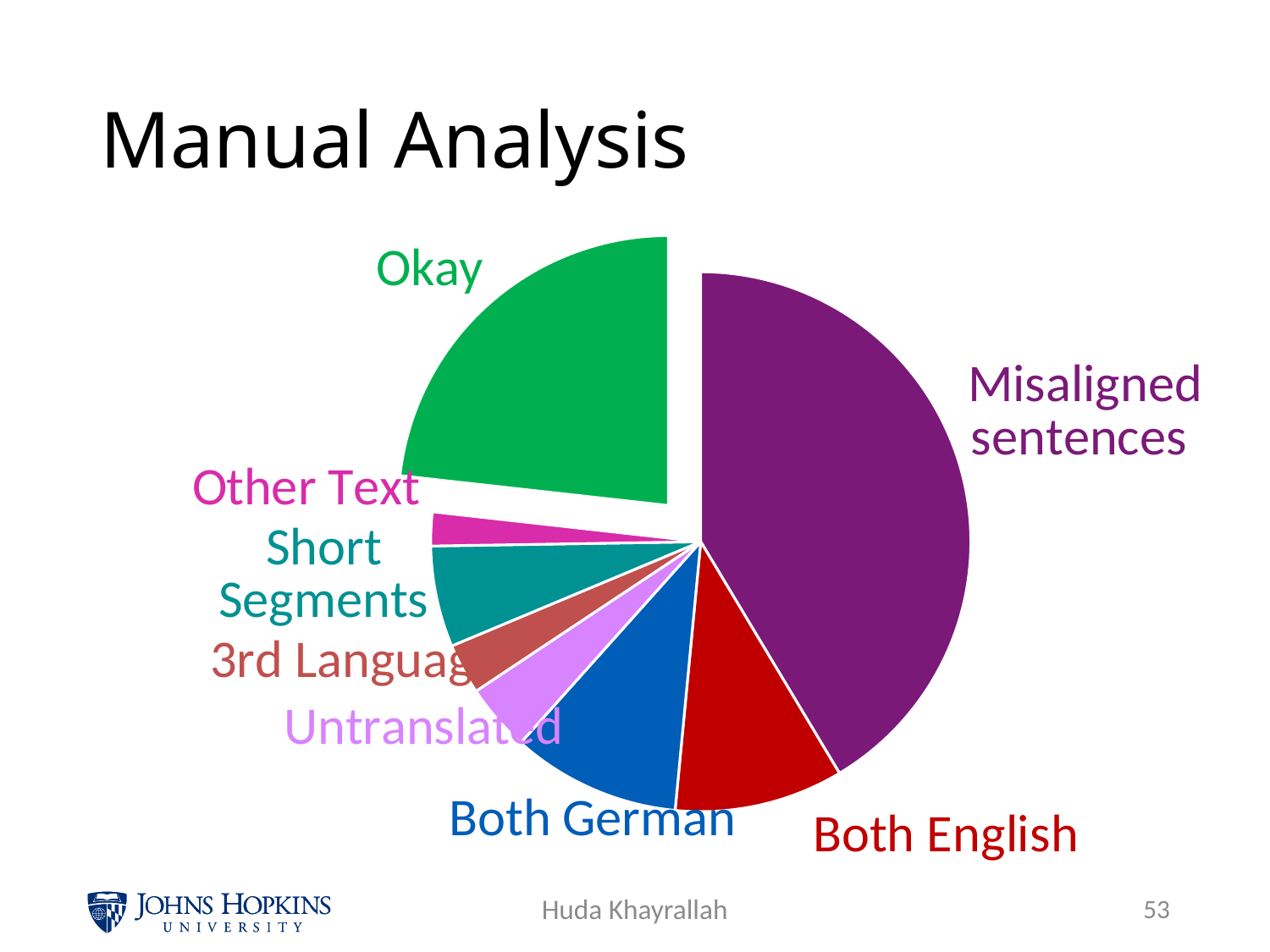
Which category has the largest slice of the pie chart? Misaligned sentences What colour is the Okay slice of the pie chart? green What is the title of the slide containing the pie chart? Manual Analysis What kind of chart is shown on the slide? pie chart Which slice is larger, Misaligned sentences or Okay? Misaligned sentences Which slice is larger, Short Segments or Other Text? Short Segments How many slices does the pie chart have? 8 Which category has the smallest slice of the pie chart? Other Text Which slice is larger, Okay or Both English? Okay